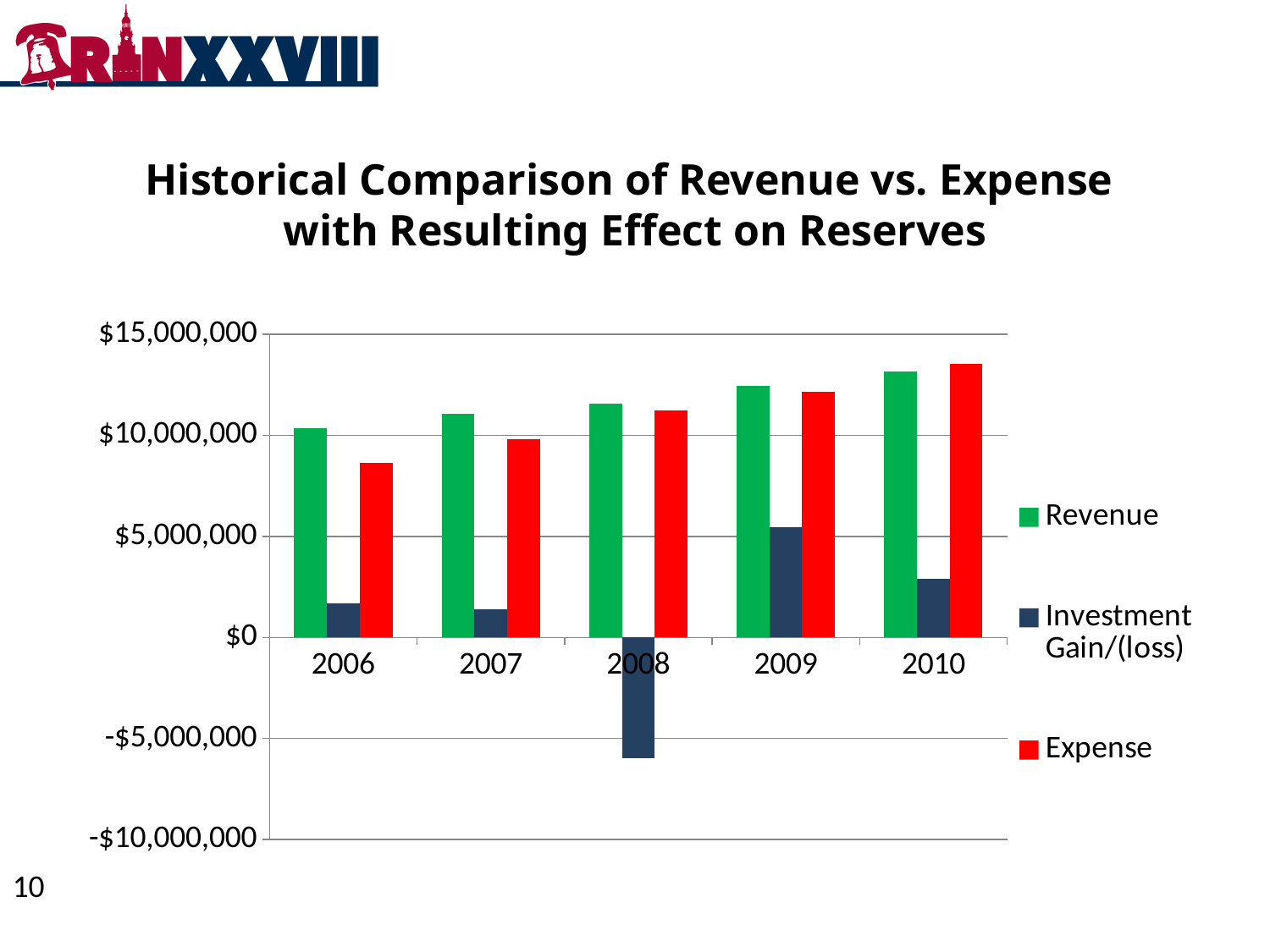
In which year is Expense lowest? 2006 What kind of chart is shown on the slide? Bar chart In 2010, which is larger, Revenue or Expense? Expense How many series does the legend list? 3 Does Expense rise or fall from 2006 to 2010? Rise Is the Expense value for 2006 greater or less than $10,000,000? less What colour represents Expense in the legend? Red In which year is Investment Gain/(loss) highest? 2009 Does Revenue rise or fall from 2006 to 2010? Rise How many years are shown on the x axis? 5 Is the Investment Gain/(loss) value for 2008 greater or less than -$5,000,000? less In which year is Investment Gain/(loss) lowest? 2008